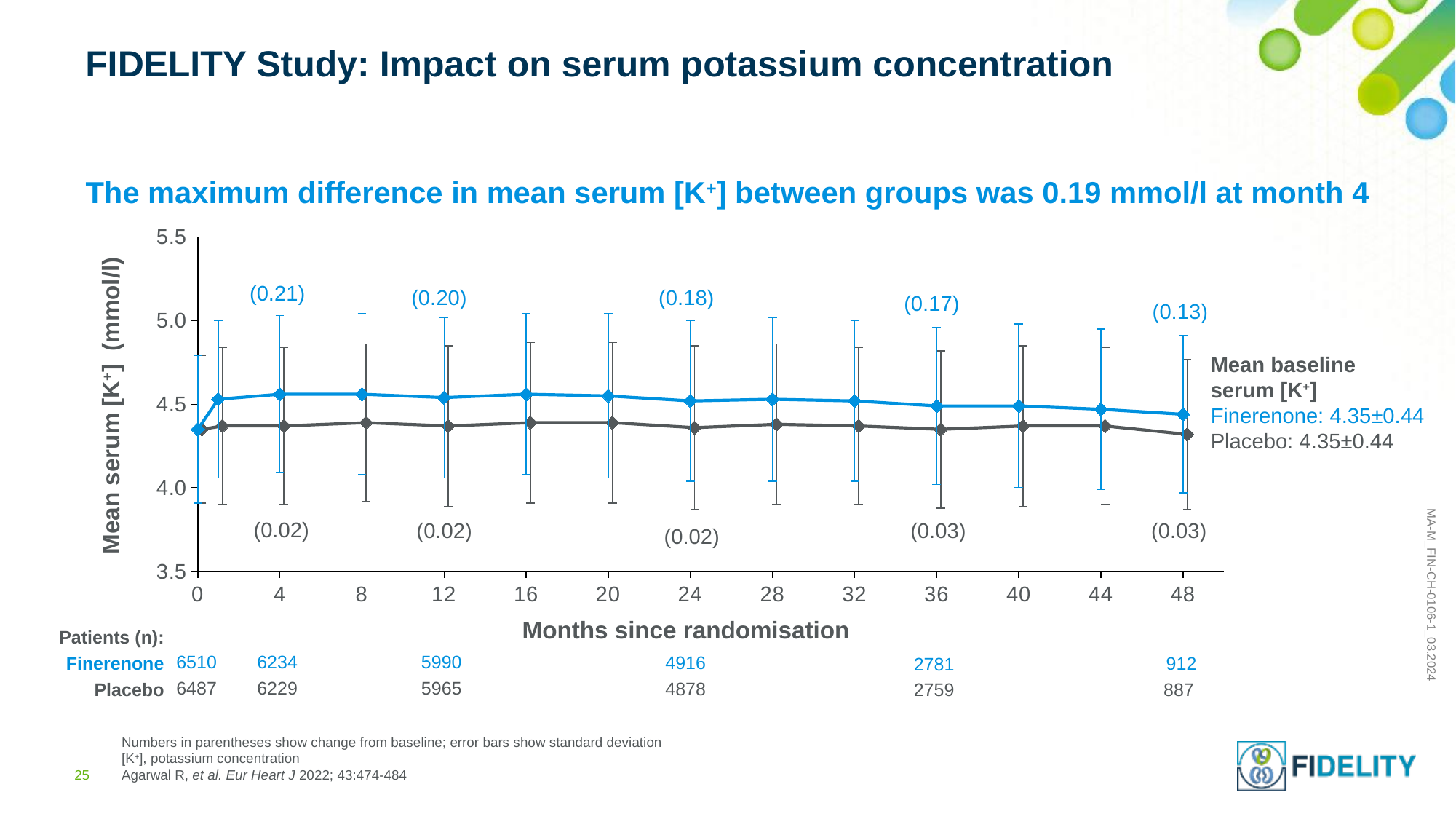
How many tick labels are shown on the x axis (months since randomisation)? 13 How many finerenone patients are listed at month 48? 912 What is the labelled change from baseline in mean serum [K+] for finerenone at month 4? 0.21 Does the finerenone line rise or fall between month 4 and month 48? fall What kind of chart is shown on the slide? line chart At which month is the labelled change from baseline for finerenone the largest? Month 4 Is the mean serum [K+] for placebo at month 4 greater or less than 4.5? less At month 24, which group has the higher mean serum [K+]? Finerenone What is the difference between the labelled change from baseline for finerenone and for placebo at month 4? 0.19 What is the mean baseline serum [K+] given for the finerenone group? 4.35±0.44 What is the labelled change from baseline in mean serum [K+] for placebo at month 48? 0.03 At which month is the labelled change from baseline for finerenone the smallest? Month 48